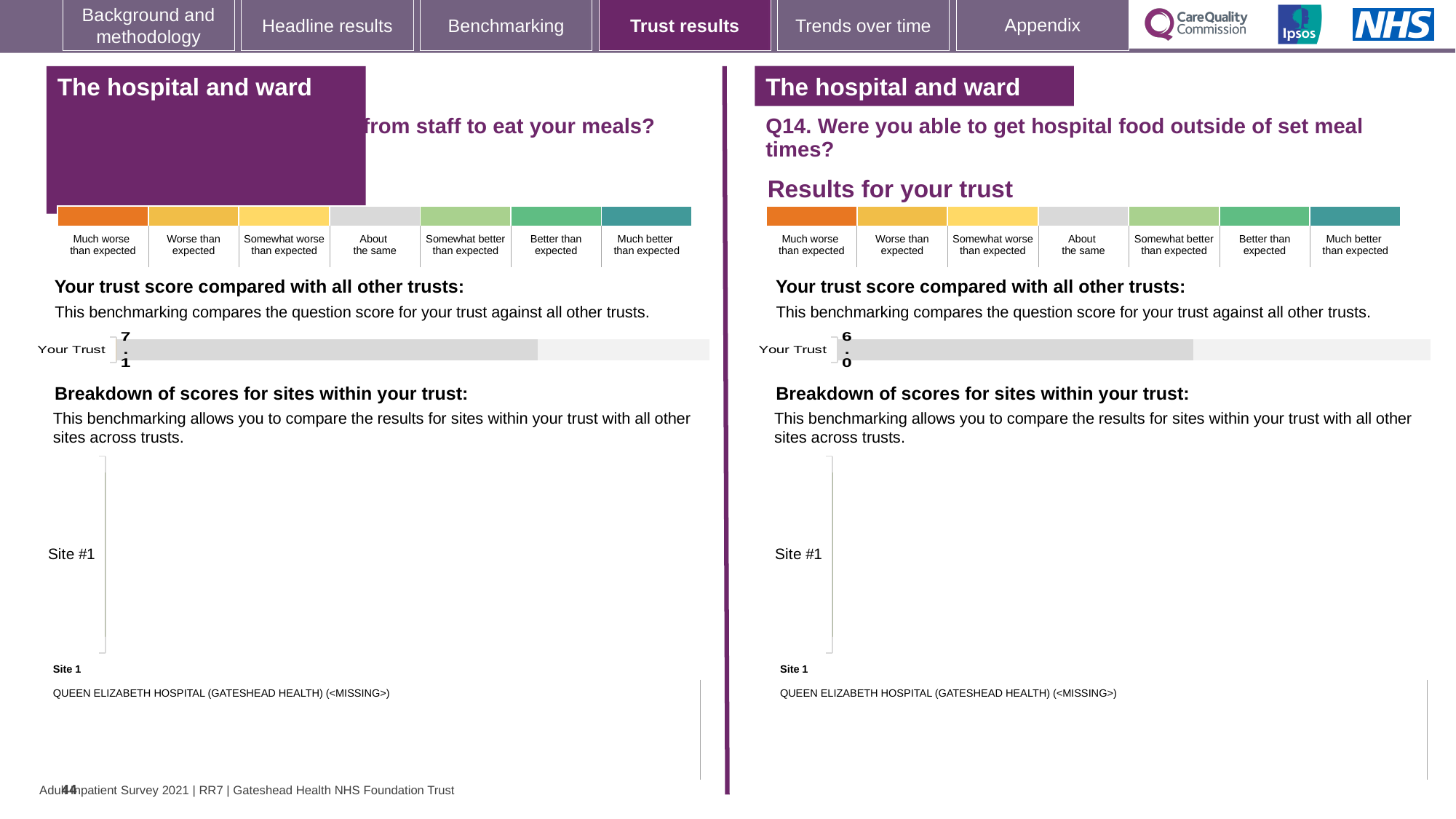
On the right panel (Q14), how many sites are listed in the 'Breakdown of scores for sites within your trust' chart? 1 On the right panel (Q14), what colour represents 'Much worse than expected' in the colour key? Orange Which panel shows the higher Your Trust score: the left panel or the right panel (Q14)? Left panel What kind of chart is used to show the Your Trust score on the right panel (Q14)? Bar chart On the left panel, which site is listed as Site 1 in the breakdown of scores? QUEEN ELIZABETH HOSPITAL (GATESHEAD HEALTH) (<MISSING>) On the left panel's 'Your trust score compared with all other trusts' chart, what is the score shown for Your Trust? 7.1 What is the difference between the Your Trust score on the left panel (7.1) and the Your Trust score on the right panel (6.0)? 1.1 On the right panel (Q14) 'Your trust score compared with all other trusts' chart, what is the score shown for Your Trust? 6.0 How many rating categories are shown in the colour key above the right panel's (Q14) trust score chart? 7